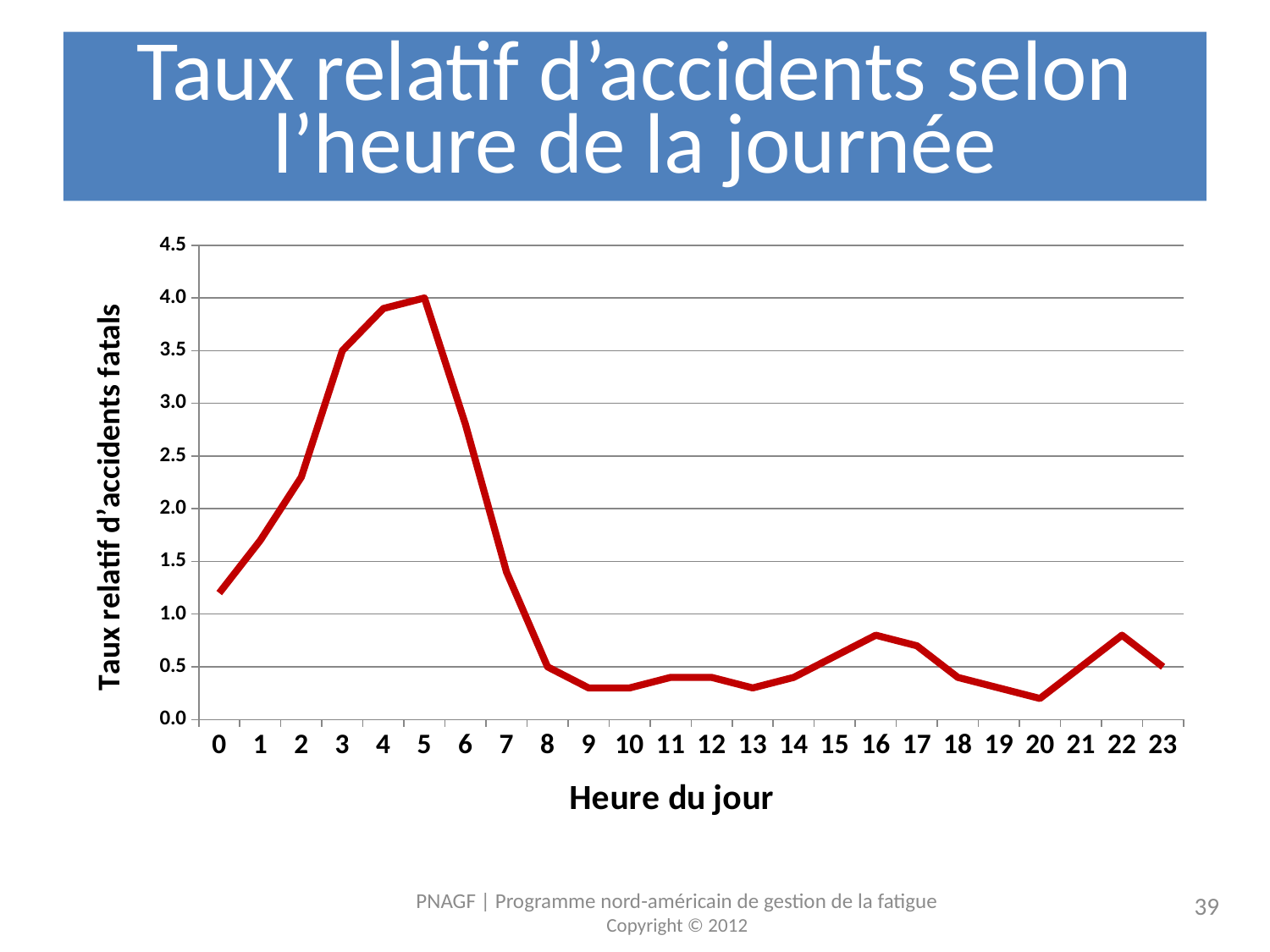
Which hour has a higher relative accident rate, hour 4 or hour 9? hour 4 What kind of chart is shown on the slide? line chart What is the label of the x axis? Heure du jour Is the value at hour 6 greater or less than 2.5? greater Between hour 5 and hour 8, does the relative accident rate rise or fall? fall How many hours (data points) are plotted along the x axis? 24 Is the value at hour 2 greater or less than 2.0? greater At which hour of the day is the relative rate of fatal accidents highest? 5 At which hour of the day is the relative rate of fatal accidents lowest? 20 Is the value at hour 7 greater or less than 1.5? less What is the relative rate of fatal accidents at hour 5? 4.0 What is the title of the chart on the slide? Taux relatif d’accidents selon l’heure de la journée